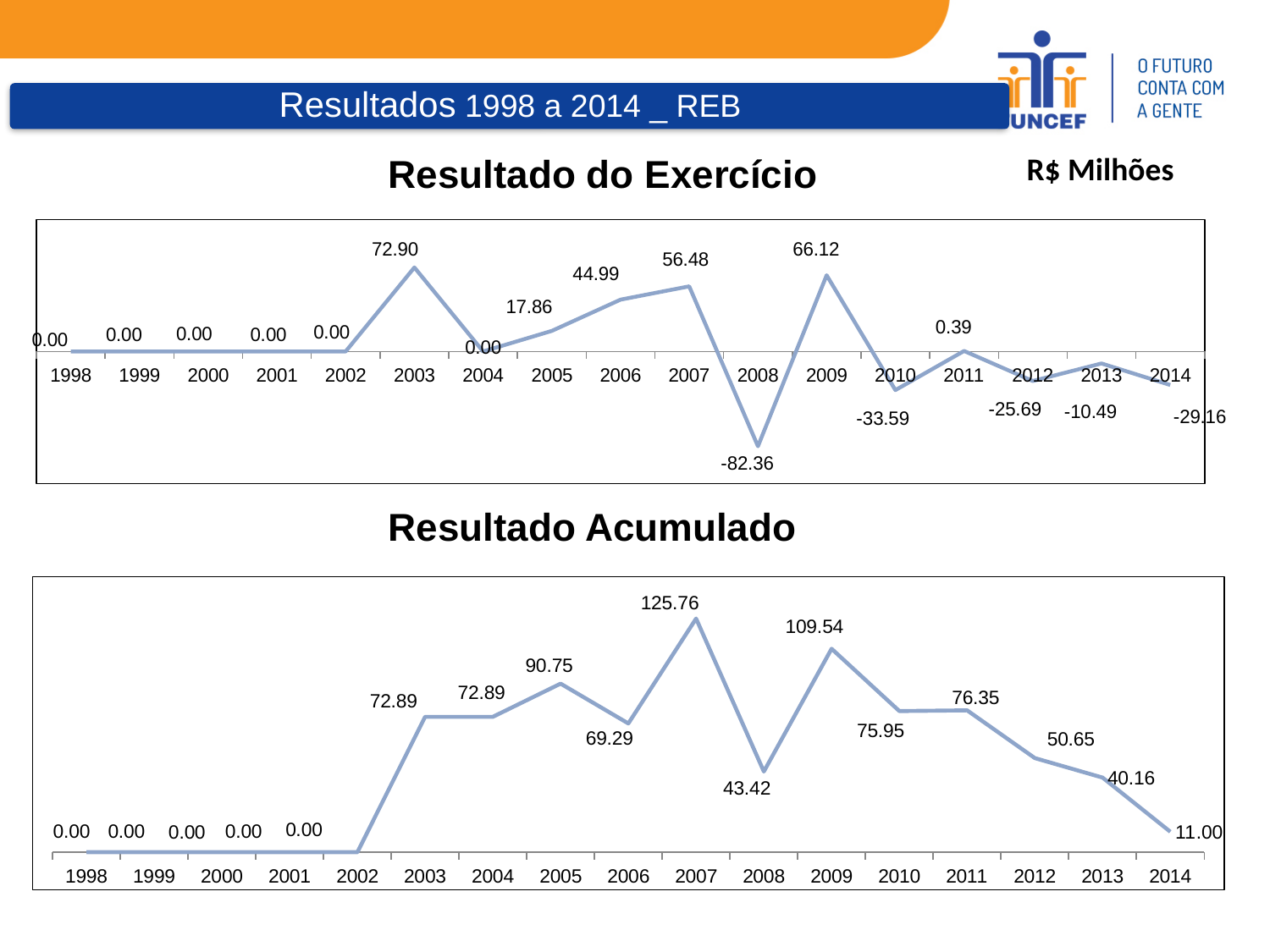
In the 'Resultado do Exercício' chart, which is larger, the value for 2009 or the value for 2007? 2009 In the 'Resultado Acumulado' chart, what is the value for 2014? 11.00 In the 'Resultado Acumulado' chart, which year has the highest value? 2007 In the 'Resultado do Exercício' chart, what is the value for 2003? 72.90 In the 'Resultado Acumulado' chart, what is the value for 2007? 125.76 In the 'Resultado do Exercício' chart, which year has the lowest value? 2008 In the 'Resultado Acumulado' chart, what is the difference between the values for 2009 and 2008? 66.12 In the 'Resultado do Exercício' chart, what is the difference between the values for 2007 and 2006? 11.49 What type of chart is the 'Resultado Acumulado' chart? Line chart How many years are plotted on the x axis of the 'Resultado Acumulado' chart? 17 In the 'Resultado do Exercício' chart, which year has the highest value? 2003 In the 'Resultado do Exercício' chart, what is the value for 2008? -82.36